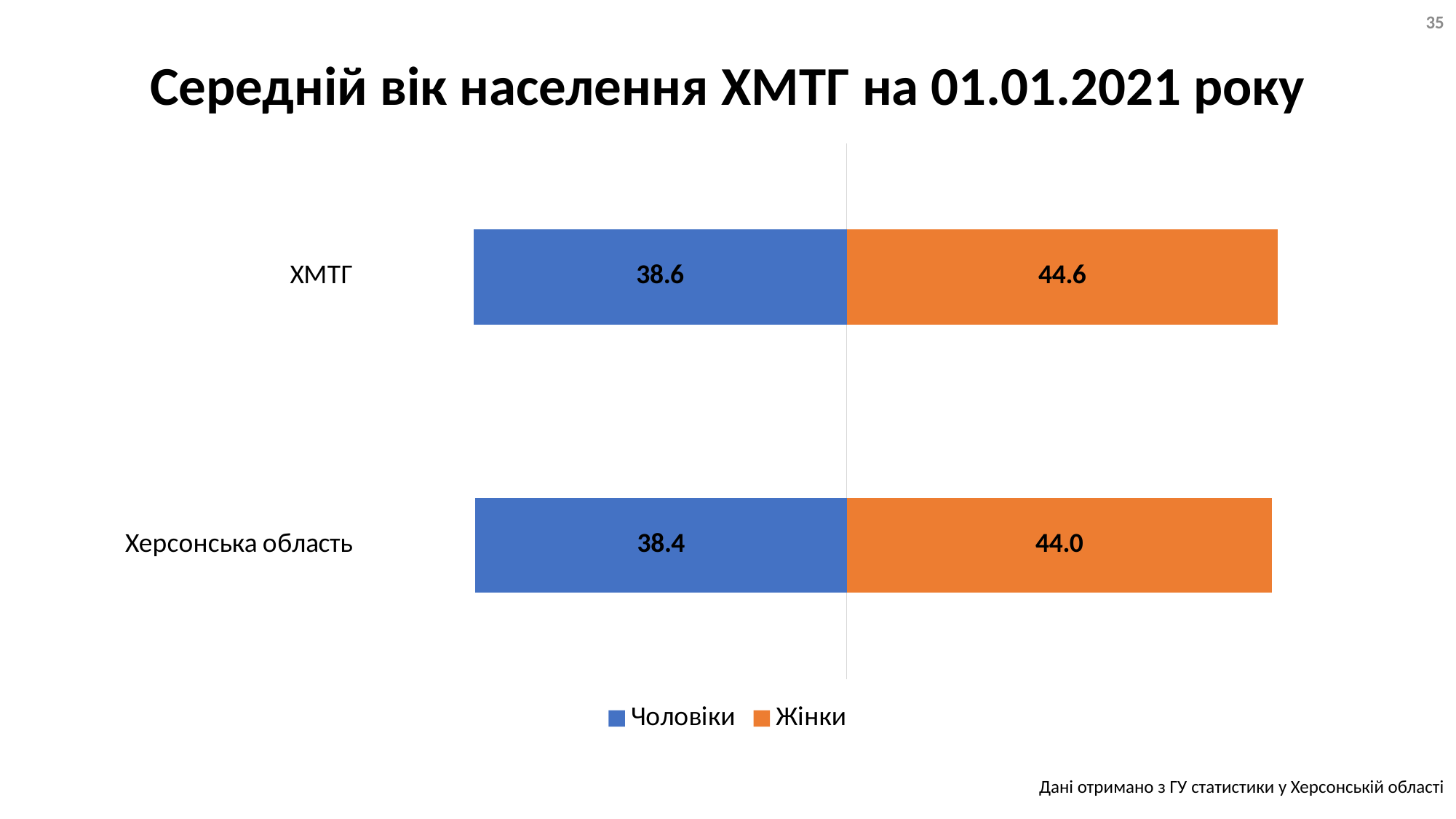
Which category has the lower value for Чоловіки? Херсонська область What is the value for Жінки in Херсонська область? 44.0 What is the value for Чоловіки in Херсонська область? 38.4 What kind of chart is shown on the slide? Bar chart Which category has the higher value for Жінки? ХМТГ What is the value for Жінки in ХМТГ? 44.6 How many categories are shown on the chart? 2 What is the value for Чоловіки in ХМТГ? 38.6 What is the difference between the Жінки and Чоловіки values for ХМТГ? 6.0 How many series does the legend list? 2 What is the difference between the Жінки values for ХМТГ and Херсонська область? 0.6 Which is larger: the Чоловіки value for ХМТГ or the Чоловіки value for Херсонська область? ХМТГ